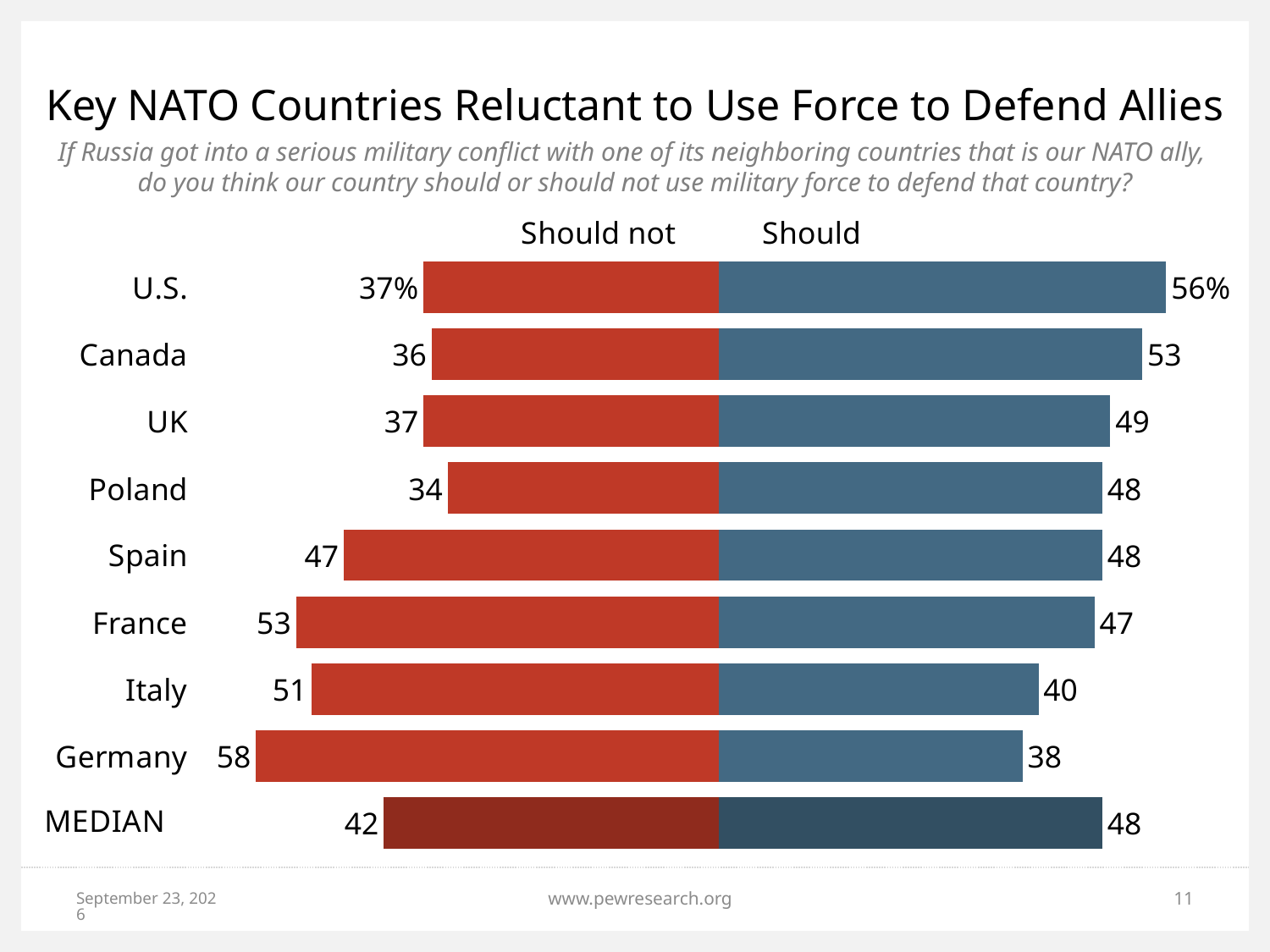
How many series does the chart show? 2 Which country has the lowest 'Should not' value? Poland Which country has the highest 'Should' value? U.S. What kind of chart is shown on the slide? Bar chart What is the difference between the 'Should' and 'Should not' values for France? 6 What is the 'Should' value for Italy? 40 Which country has the lowest 'Should' value? Germany Is the 'Should' value larger for Canada or for the UK? Canada What is the 'Should not' value for Germany? 58 How many countries are listed in the chart, excluding the MEDIAN row? 8 What is the MEDIAN 'Should not' value? 42 What percentage of U.S. respondents say their country should use military force to defend a NATO ally? 56%